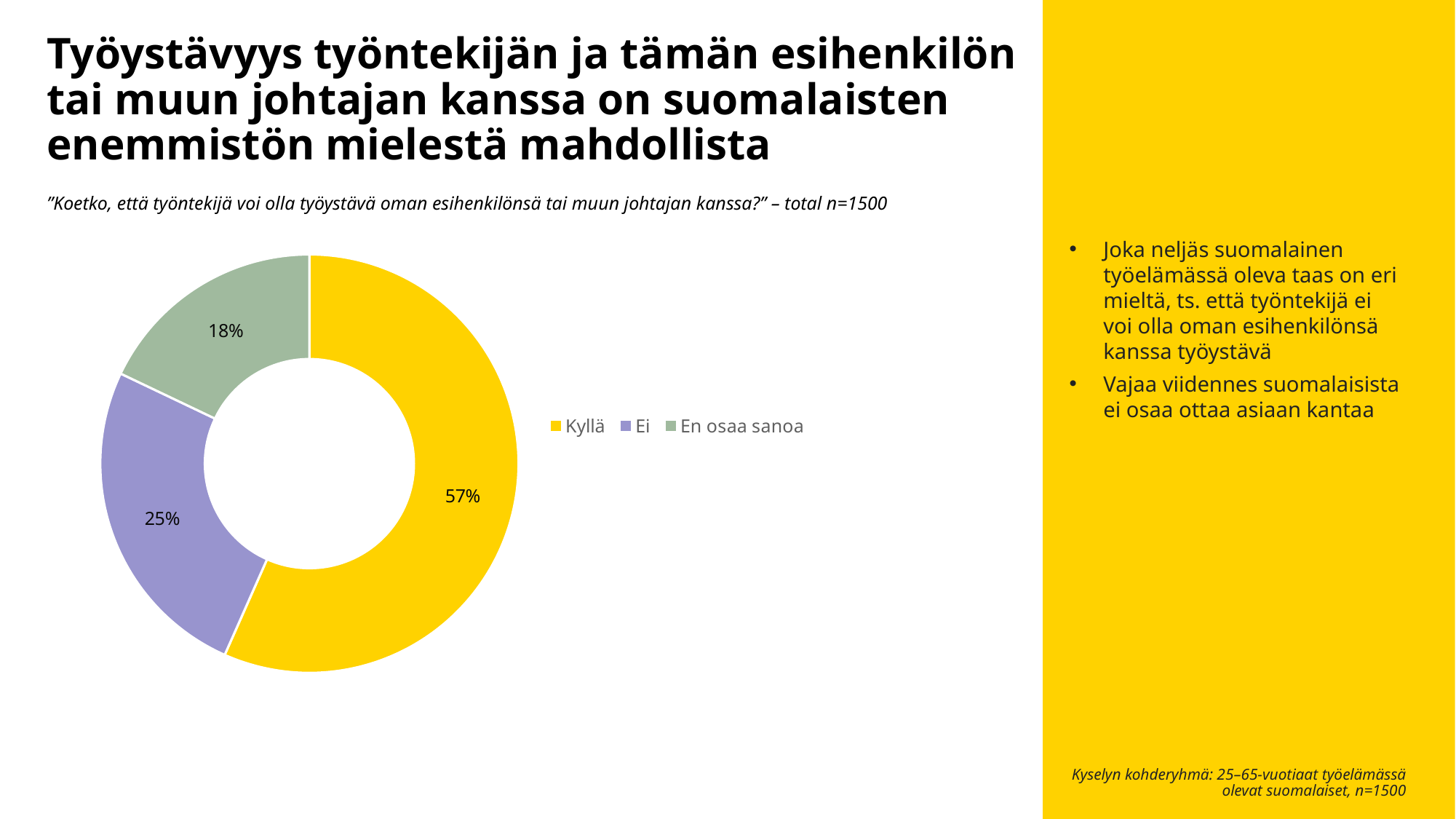
What percentage of respondents answered "En osaa sanoa"? 18% What percentage of respondents answered "Ei"? 25% Which response category has the smallest share of the chart? En osaa sanoa Which response category has the largest share of the chart? Kyllä What kind of chart is shown on the slide? Doughnut (pie) chart What is the difference in percentage points between the "Ei" and "En osaa sanoa" shares? 7 What colour is the "Kyllä" segment of the chart? Yellow What percentage of respondents answered "Kyllä"? 57% Which is larger, the share for "Ei" or the share for "En osaa sanoa"? Ei What is the total sample size (n) stated for the survey question? n=1500 How many categories does the chart show? 3 What is the difference in percentage points between the "Kyllä" and "Ei" shares? 32